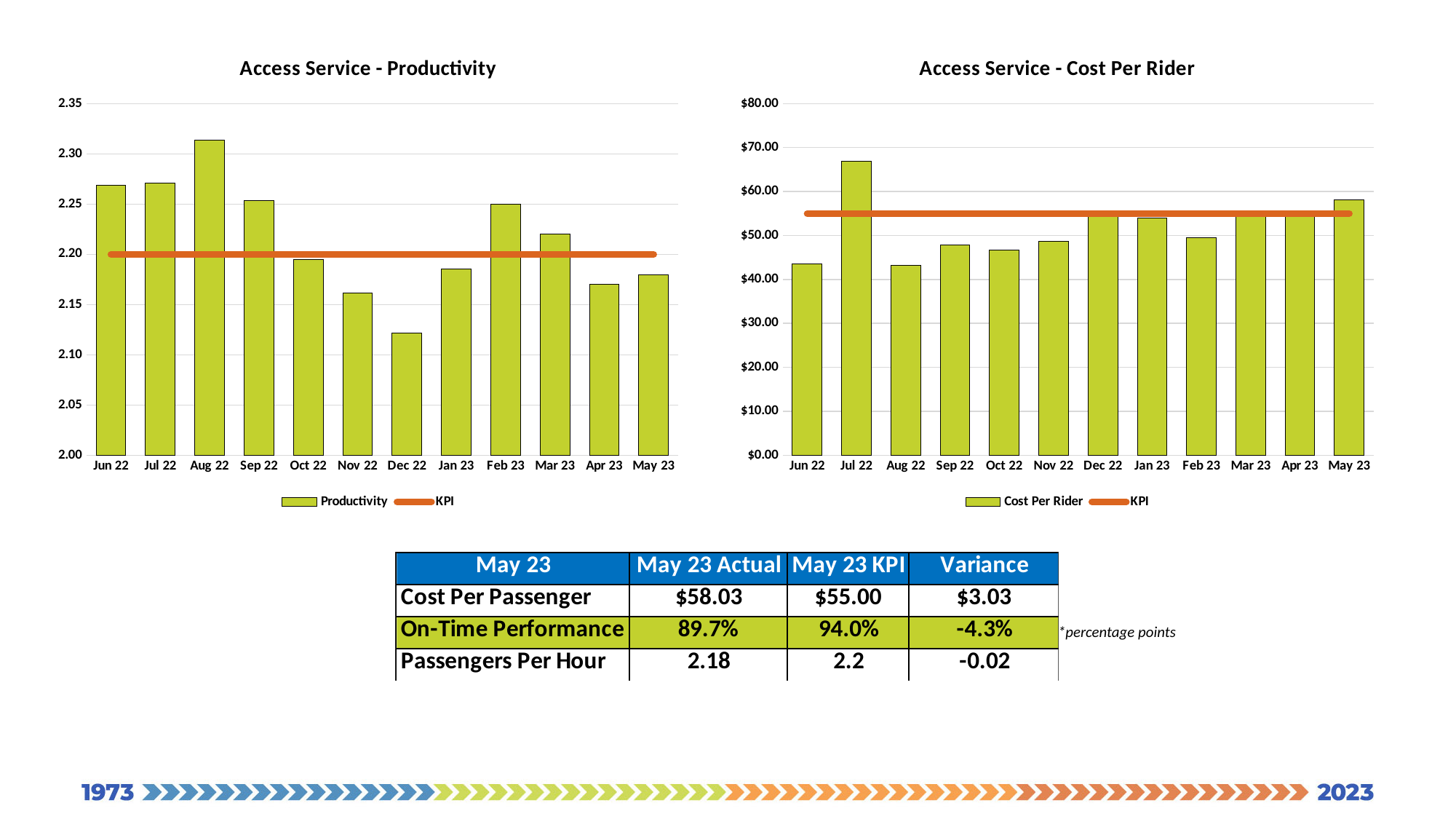
How many entries does the legend of the 'Access Service - Cost Per Rider' chart list? 2 What are the two legend entries of the 'Access Service - Cost Per Rider' chart? Cost Per Rider and KPI In the 'Access Service - Productivity' chart, which month has the lowest productivity bar? Dec 22 In the 'Access Service - Cost Per Rider' chart, is the value for Jul 22 greater or less than $60.00? greater In the 'Access Service - Productivity' chart, which month has the highest productivity bar? Aug 22 In the 'Access Service - Productivity' chart, is the value for Dec 22 greater or less than 2.15? less In the 'Access Service - Productivity' chart, which is higher, Feb 23 or Nov 22? Feb 23 In the 'Access Service - Productivity' chart, is the value for Aug 22 greater or less than 2.30? greater In the 'Access Service - Cost Per Rider' chart, which month has the highest cost per rider? Jul 22 In the 'Access Service - Productivity' chart, at what value is the KPI line drawn? 2.20 What type of chart is the 'Access Service - Productivity' chart? bar chart How many months are shown on the x axis of the 'Access Service - Productivity' chart? 12